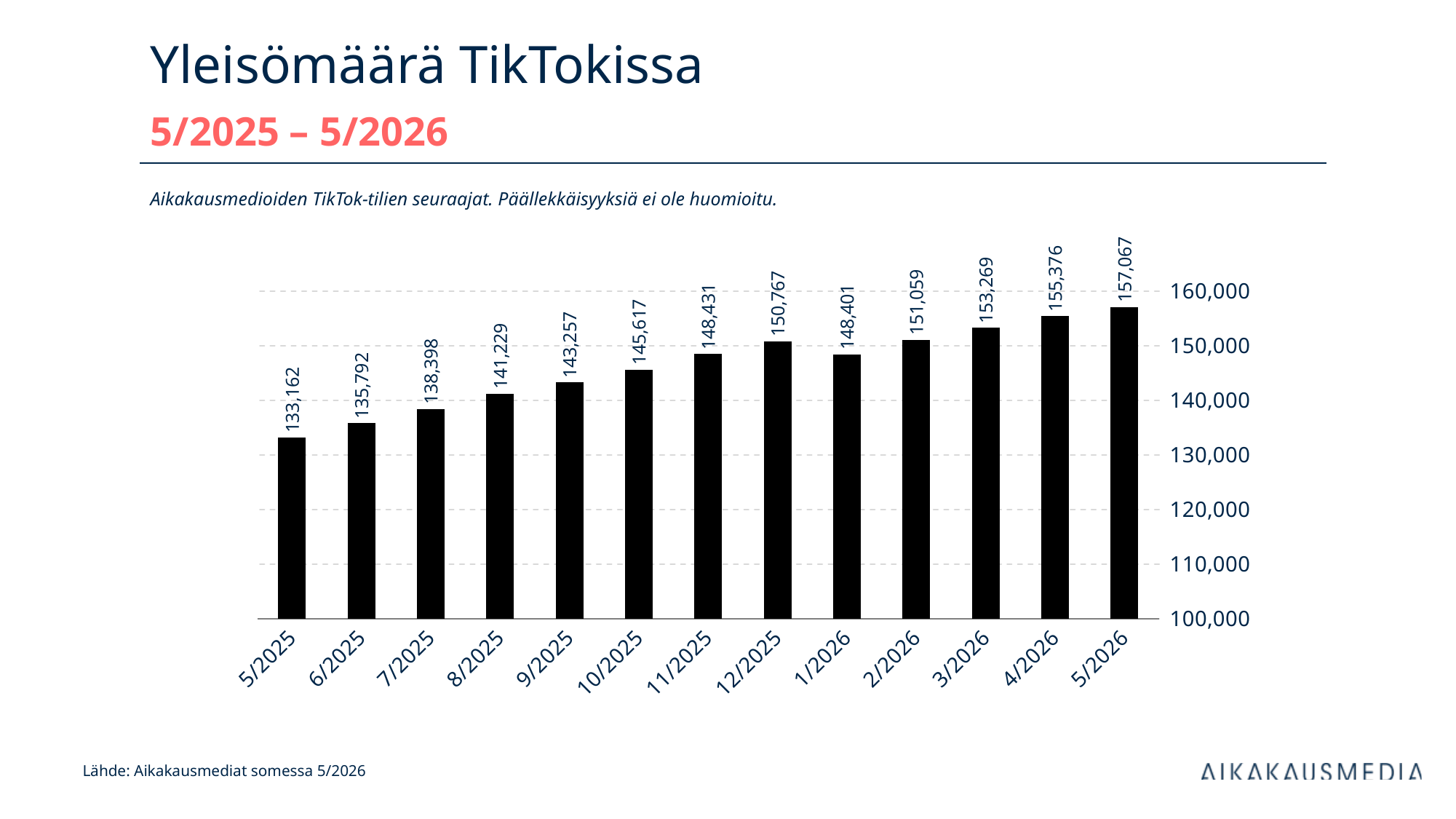
What is the title of the chart? Yleisömäärä TikTokissa What is the value for 1/2026? 148,401 What is the value for 12/2025? 150,767 Which month has the lowest value? 5/2025 What kind of chart is shown on the slide? bar chart How many months are shown on the x axis? 13 Do the values generally rise or fall from 5/2025 to 5/2026? rise Which month has the highest value? 5/2026 What is the value for 5/2025? 133,162 Is the value for 8/2025 greater or less than 140,000? greater Which is larger, the value for 12/2025 or the value for 1/2026? 12/2025 What is the difference between the values for 5/2026 and 5/2025? 23,905